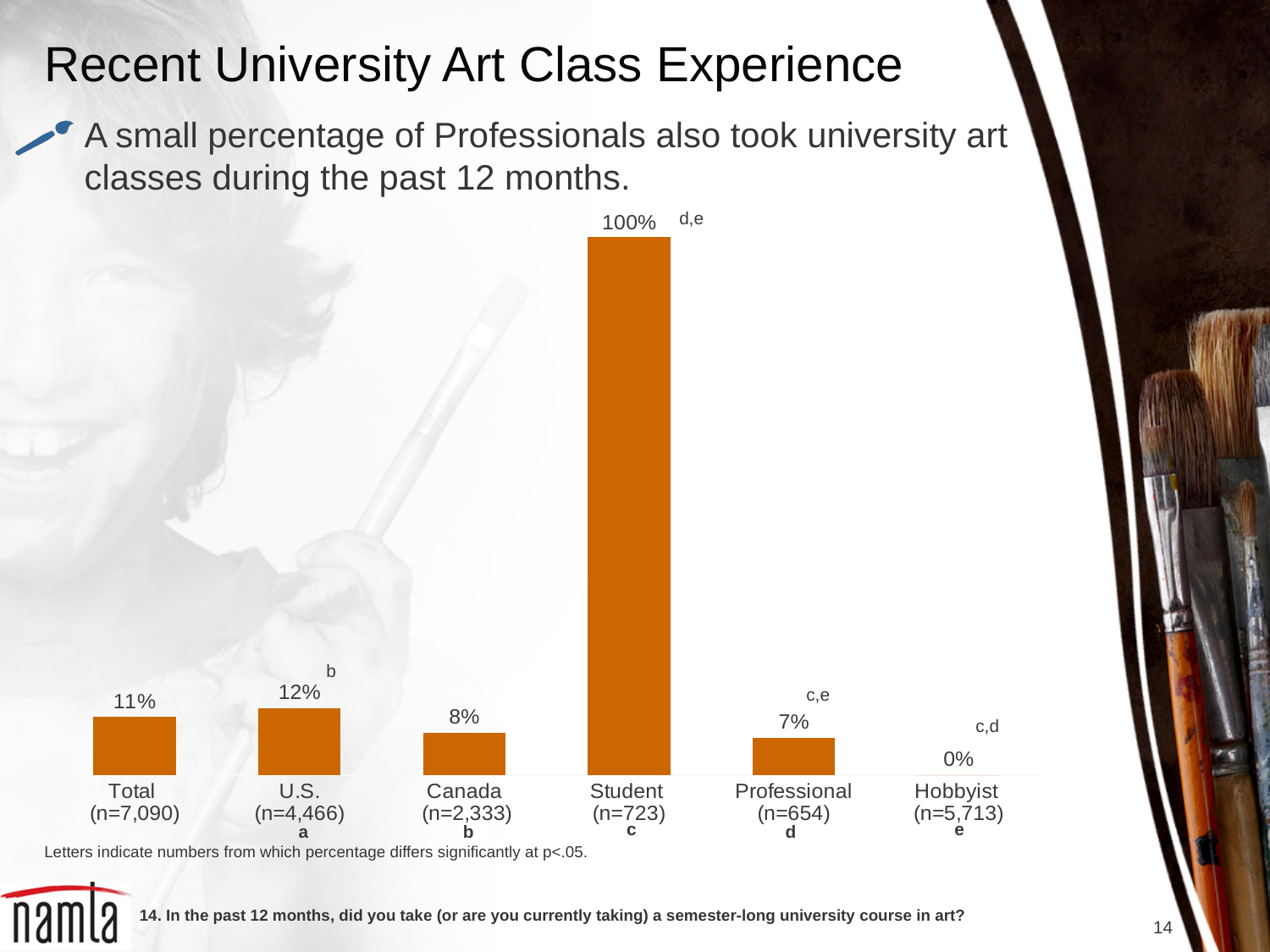
What type of chart is shown on the slide? Bar chart What percentage is shown for Canada? 8% Which category has the highest percentage? Student How many categories are shown in the chart? 6 What percentage is shown for Student? 100% What percentage is shown for Hobbyist? 0% What is the difference in percentage points between U.S. and Canada? 4 What is the difference in percentage points between Total and Professional? 4 Which is larger, the percentage for U.S. or for Canada? U.S. What percentage is shown for Professional? 7% What is the sample size (n) shown for the Total category? 7,090 Which category has the lowest percentage? Hobbyist